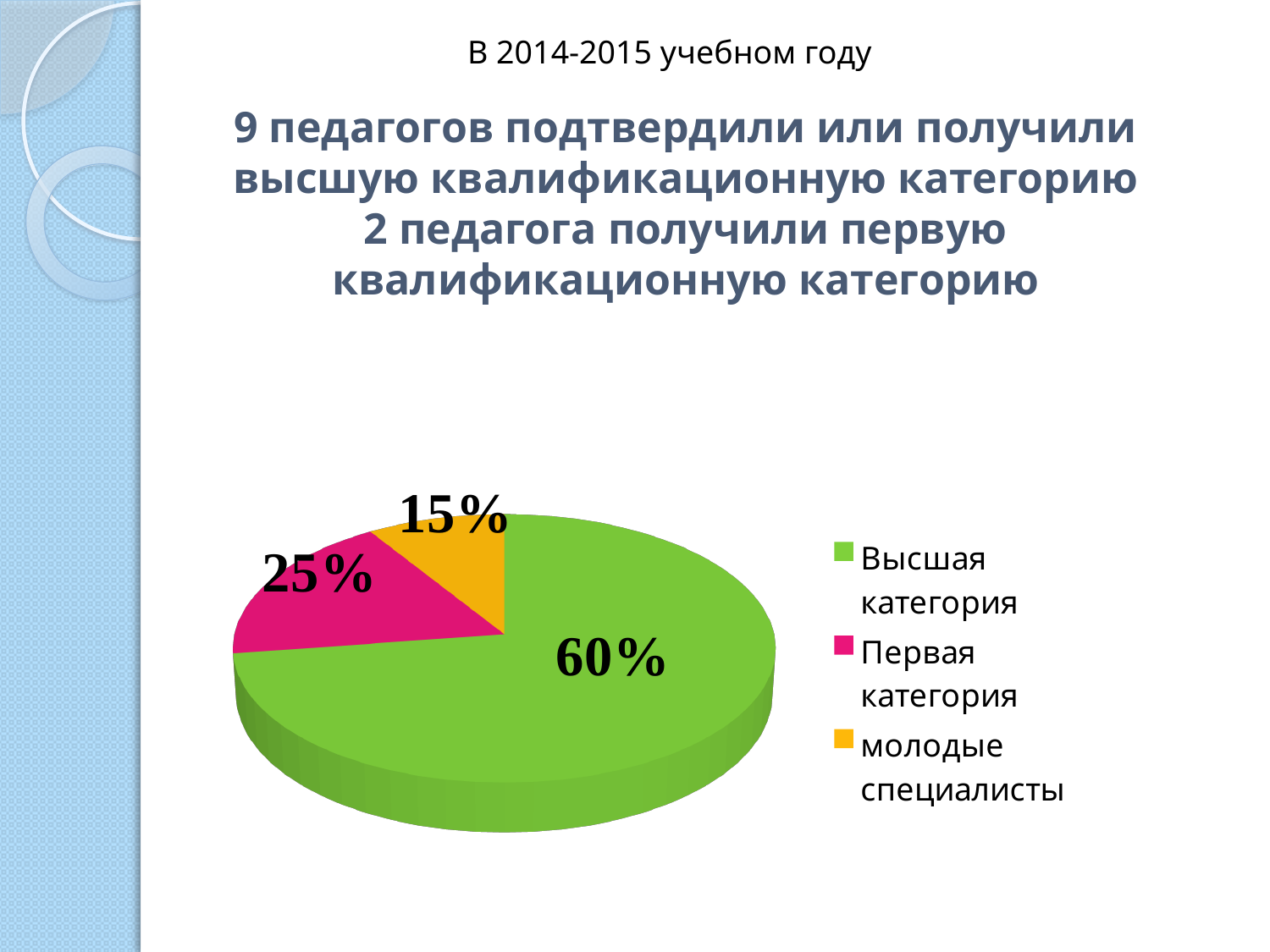
What share of the pie does 'Высшая категория' have? 60% What colour is the slice for 'Первая категория'? pink Which is larger: the share of 'Первая категория' or the share of 'молодые специалисты'? Первая категория What kind of chart is shown on the slide? pie chart What share of the pie does 'молодые специалисты' have? 15% What is the difference between the shares of 'Высшая категория' and 'Первая категория'? 35% Which category has the smallest slice of the pie? молодые специалисты How many entries does the legend list? 3 What is the difference between the shares of 'Первая категория' and 'молодые специалисты'? 10% Which category has the largest slice of the pie? Высшая категория How many categories does the pie chart have? 3 What share of the pie does 'Первая категория' have? 25%